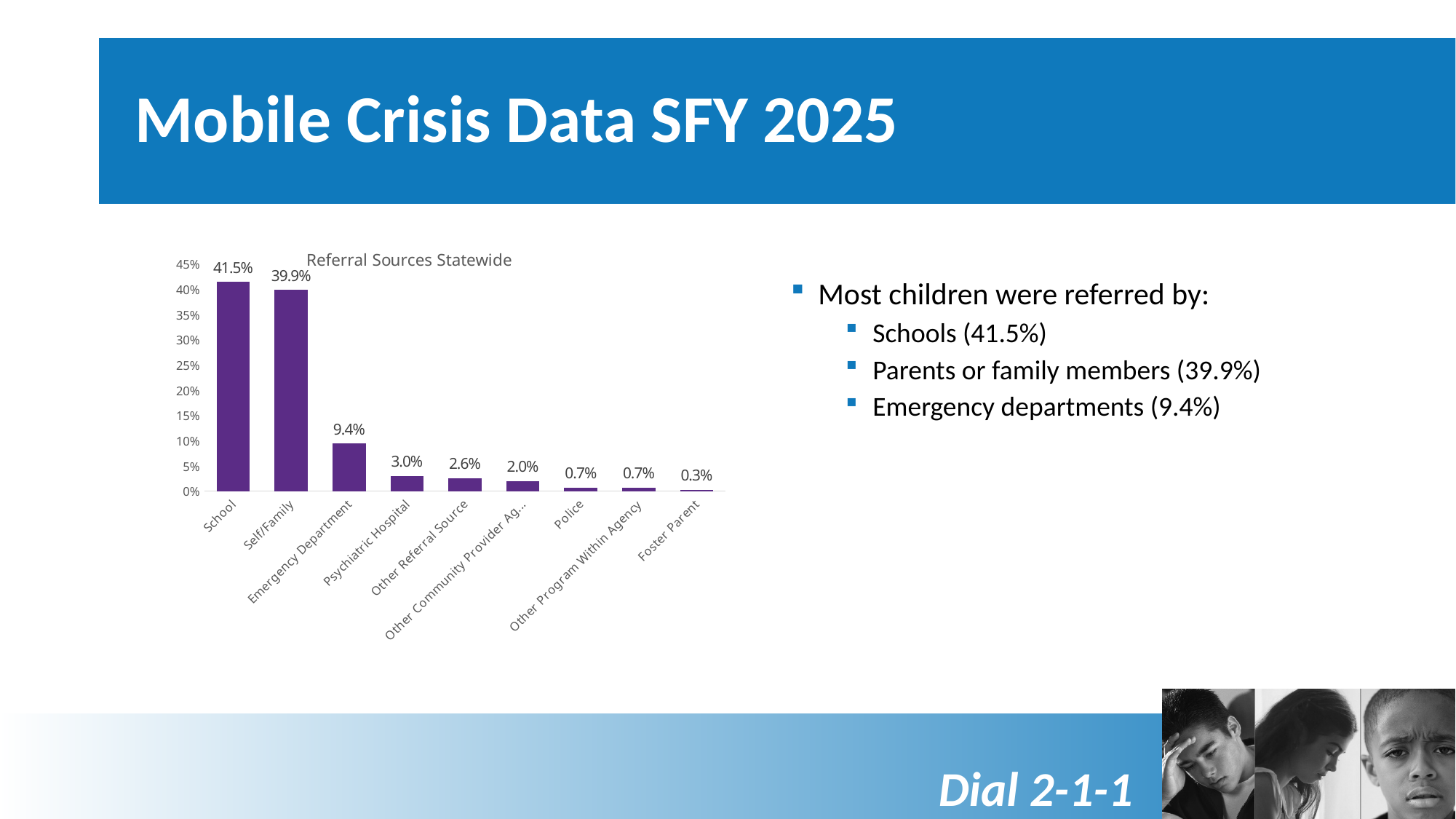
How many referral source categories are shown in the chart? 9 What is the value for School in the Referral Sources Statewide chart? 41.5% What is the value for Psychiatric Hospital? 3.0% What kind of chart is shown on the slide? bar chart What is the title of the chart? Referral Sources Statewide What is the value for Foster Parent? 0.3% Is the value for Self/Family greater or less than 35%? greater What is the value for Emergency Department? 9.4% Which is larger, the value for Other Referral Source or the value for Psychiatric Hospital? Psychiatric Hospital Which referral source has the highest value? School Which referral source has the lowest value? Foster Parent What is the difference between the values for School and Self/Family? 1.6%